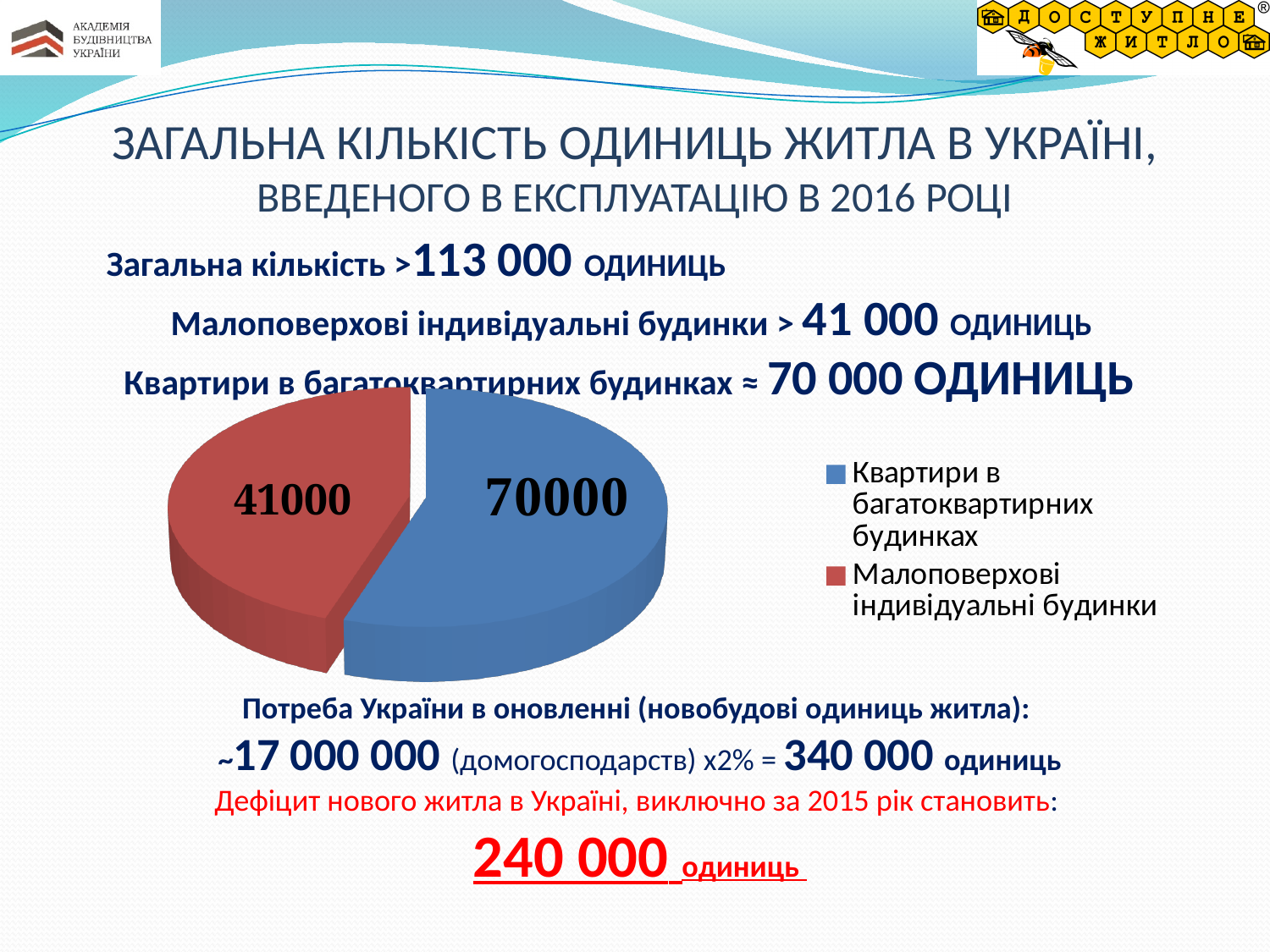
What is the total of the two values shown in the pie chart? 111000 What value is shown for the slice labelled Малоповерхові індивідуальні будинки in the pie chart? 41000 Which category has the smallest slice in the pie chart? Малоповерхові індивідуальні будинки Which category has the largest slice in the pie chart? Квартири в багатоквартирних будинках What value is shown for the slice labelled Квартири в багатоквартирних будинках in the pie chart? 70000 How many entries does the legend of the pie chart list? 2 What kind of chart is shown on the slide? Pie chart Which is larger in the pie chart: Квартири в багатоквартирних будинках or Малоповерхові індивідуальні будинки? Квартири в багатоквартирних будинках What colour is the slice for Малоповерхові індивідуальні будинки in the pie chart? Red How many slices does the pie chart have? 2 What is the difference between the two values shown in the pie chart? 29000 What colour is the slice for Квартири в багатоквартирних будинках in the pie chart? Blue